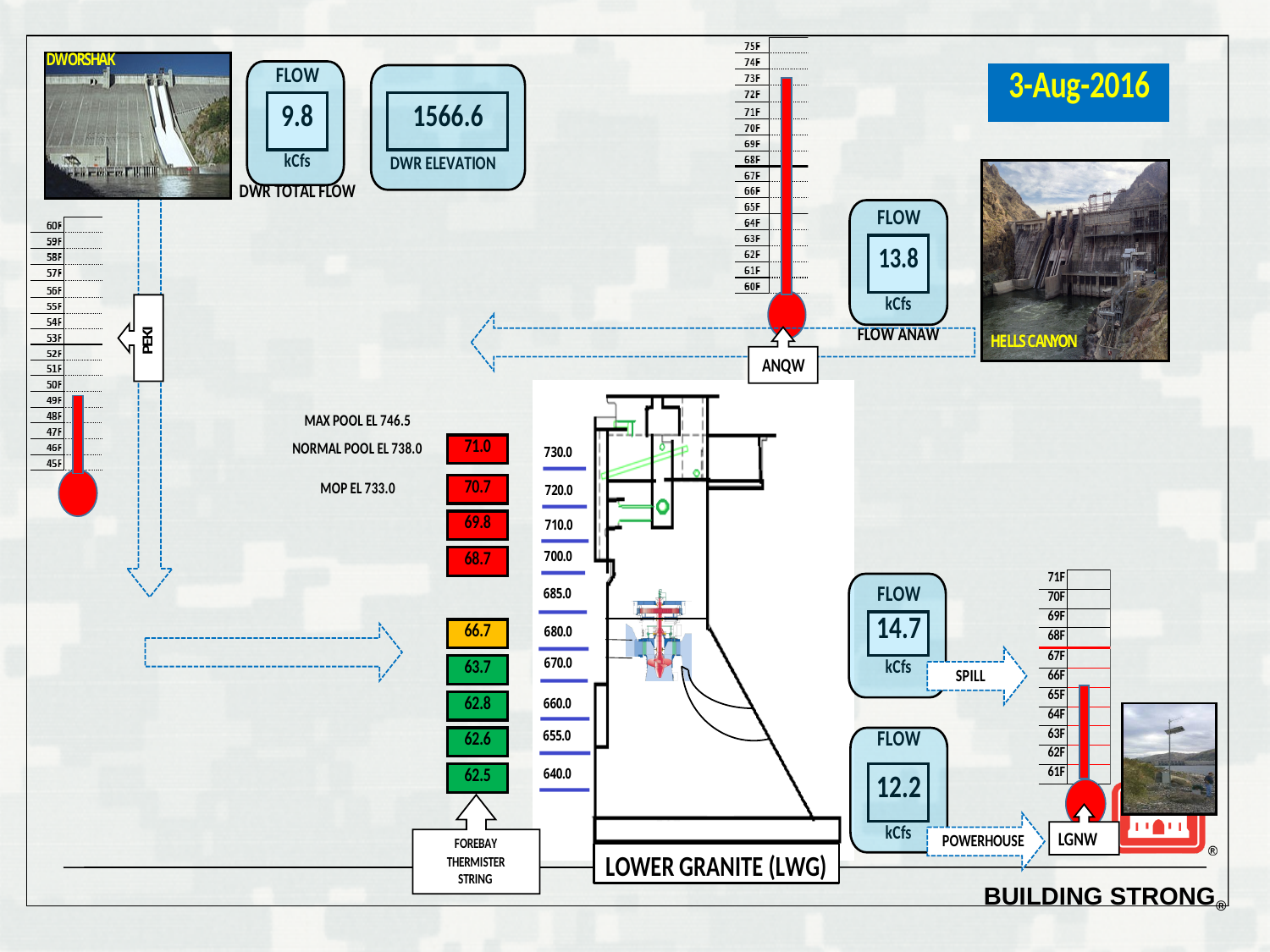
What is the DWR TOTAL FLOW value shown on the slide? 9.8 kCfs On the ANQW thermometer, is the indicated temperature greater or less than 70F? greater In the FOREBAY THERMISTER STRING column, what is the highest temperature value shown? 71.0 What is the SPILL flow value shown for Lower Granite (LWG)? 14.7 kCfs What is the FLOW ANAW value shown next to the Hells Canyon picture? 13.8 kCfs How many temperature readings are shown in the FOREBAY THERMISTER STRING column? 9 In the FOREBAY THERMISTER STRING column, what is the lowest temperature value shown? 62.5 What is the DWR ELEVATION value shown on the slide? 1566.6 What is the difference between the highest (71.0) and lowest (62.5) values in the FOREBAY THERMISTER STRING column? 8.5 What is the POWERHOUSE flow value shown for Lower Granite (LWG)? 12.2 kCfs Which is larger at Lower Granite, the SPILL flow or the POWERHOUSE flow? SPILL What date is shown on the slide? 3-Aug-2016